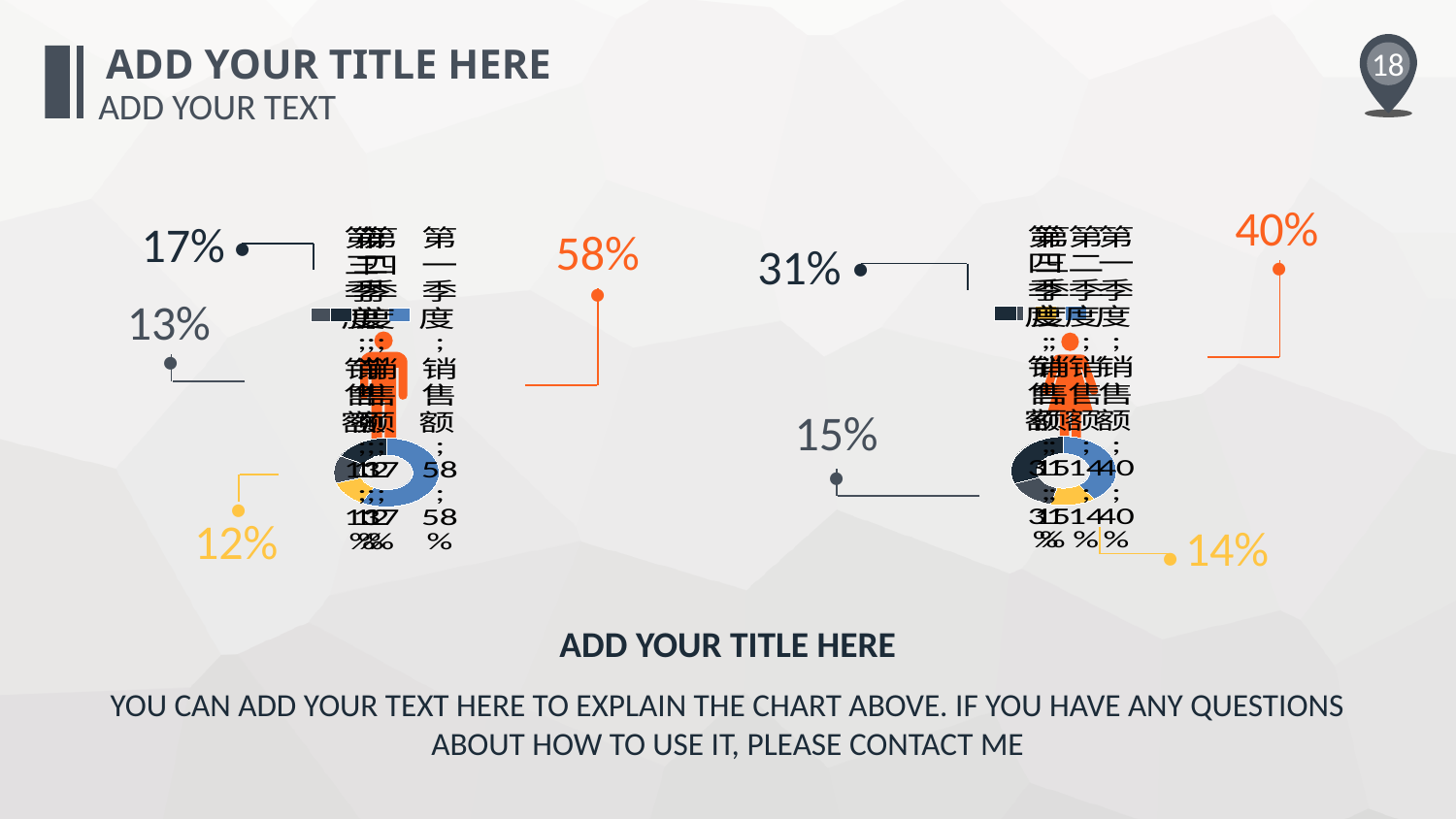
In the right chart, what is the smallest percentage shown? 14% In the left chart, what is the largest percentage shown? 58% What kind of chart is the chart on the right side of the slide? Doughnut (pie) chart What kind of chart is the chart on the left side of the slide? Doughnut (pie) chart How many slices does the right doughnut chart have? 4 In the left chart, what colour is the slice labelled 58%? Blue In the left chart, what is the smallest percentage shown? 12% In the left chart, what is the difference between the largest share (58%) and the smallest share (12%)? 46 percentage points In the right chart, what is the largest percentage shown? 40% In the right chart, what is the difference between the 31% share and the 15% share? 16 percentage points How many slices does the left doughnut chart have? 4 Which is larger: the largest slice of the left chart or the largest slice of the right chart? The left chart's largest slice (58%)